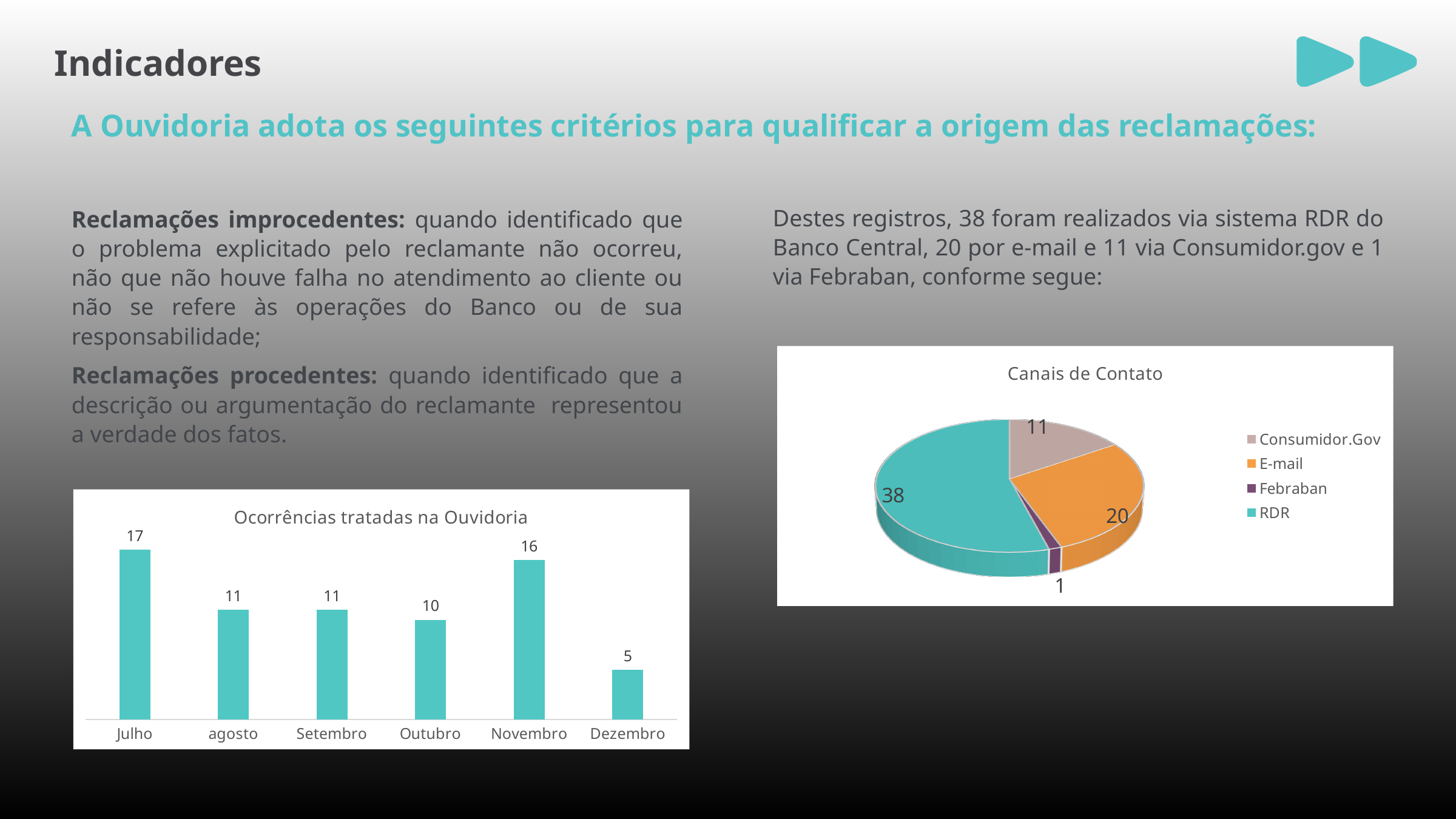
In the chart 'Canais de Contato', which channel has the smallest slice? Febraban In the chart 'Ocorrências tratadas na Ouvidoria', what is the value for Julho? 17 In the chart 'Ocorrências tratadas na Ouvidoria', which month has the highest value? Julho In the chart 'Ocorrências tratadas na Ouvidoria', what is the difference between the values for Novembro and Dezembro? 11 In the chart 'Ocorrências tratadas na Ouvidoria', which month has the lowest value? Dezembro In the chart 'Canais de Contato', what is the value for RDR? 38 In the chart 'Ocorrências tratadas na Ouvidoria', is the value for Outubro larger or smaller than the value for Novembro? smaller In the chart 'Canais de Contato', what is the difference between the values for E-mail and Consumidor.Gov? 9 What kind of chart is 'Canais de Contato'? pie chart How many entries does the legend of the chart 'Canais de Contato' list? 4 In the chart 'Ocorrências tratadas na Ouvidoria', how many months are shown on the x axis? 6 What kind of chart is 'Ocorrências tratadas na Ouvidoria'? bar chart